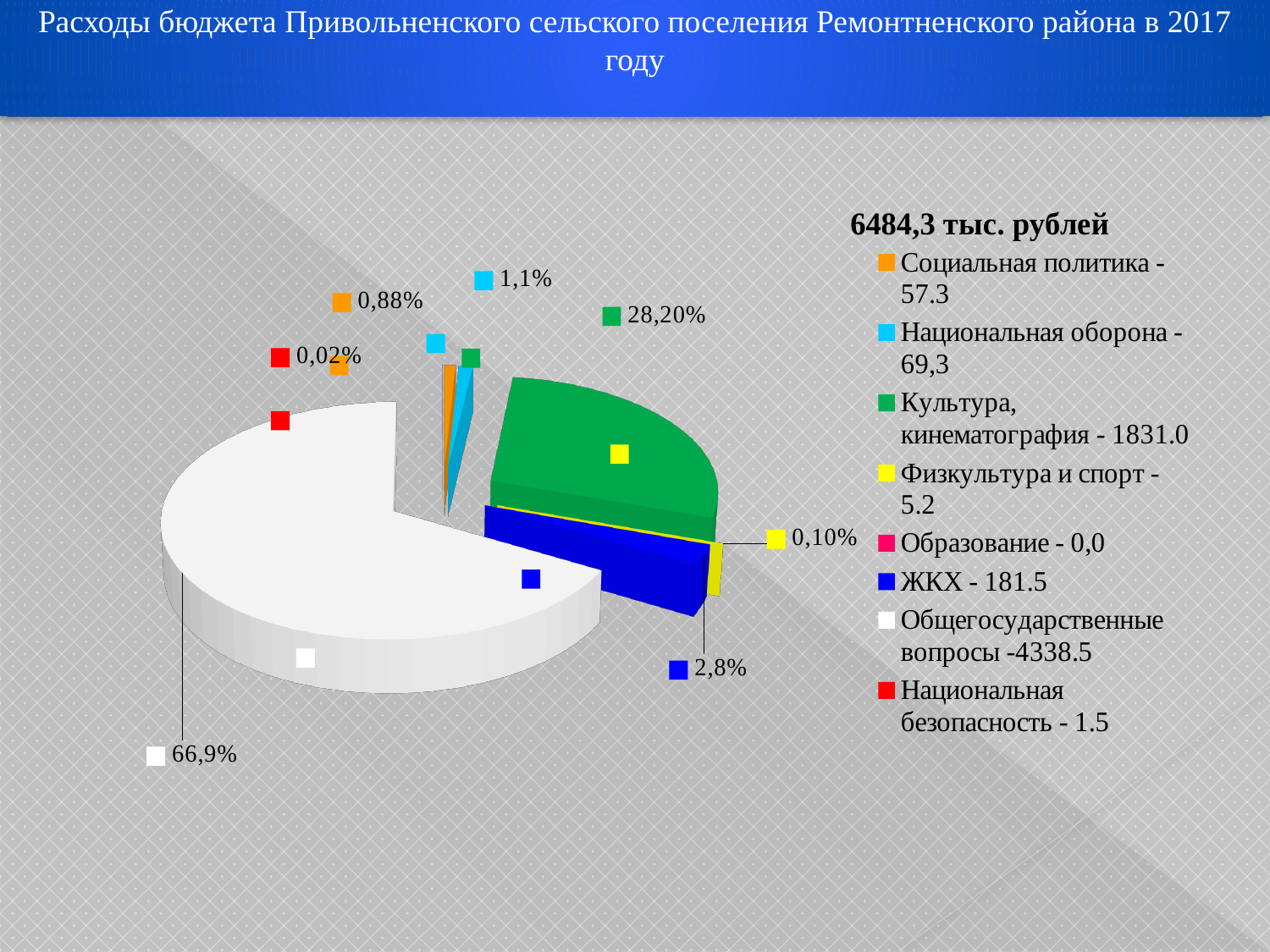
Which is larger, the share for Культура, кинематография or the share for ЖКХ? Культура, кинематография What percentage share is labelled for the green slice (Культура, кинематография)? 28,20% What total amount in thousand rubles is shown above the legend? 6484,3 тыс. рублей How many entries does the legend list? 8 What percentage share is labelled for the light blue slice (Национальная оборона)? 1,1% Which category has the largest share of the pie? Общегосударственные вопросы What kind of chart is shown on the slide? pie chart What percentage share is labelled for the blue slice (ЖКХ)? 2,8% What percentage share is labelled for the orange slice (Социальная политика)? 0,88% What percentage share is labelled for the yellow slice (Физкультура и спорт)? 0,10% What percentage share is labelled for the white slice (Общегосударственные вопросы)? 66,9% What value is given in the legend for Культура, кинематография? 1831.0